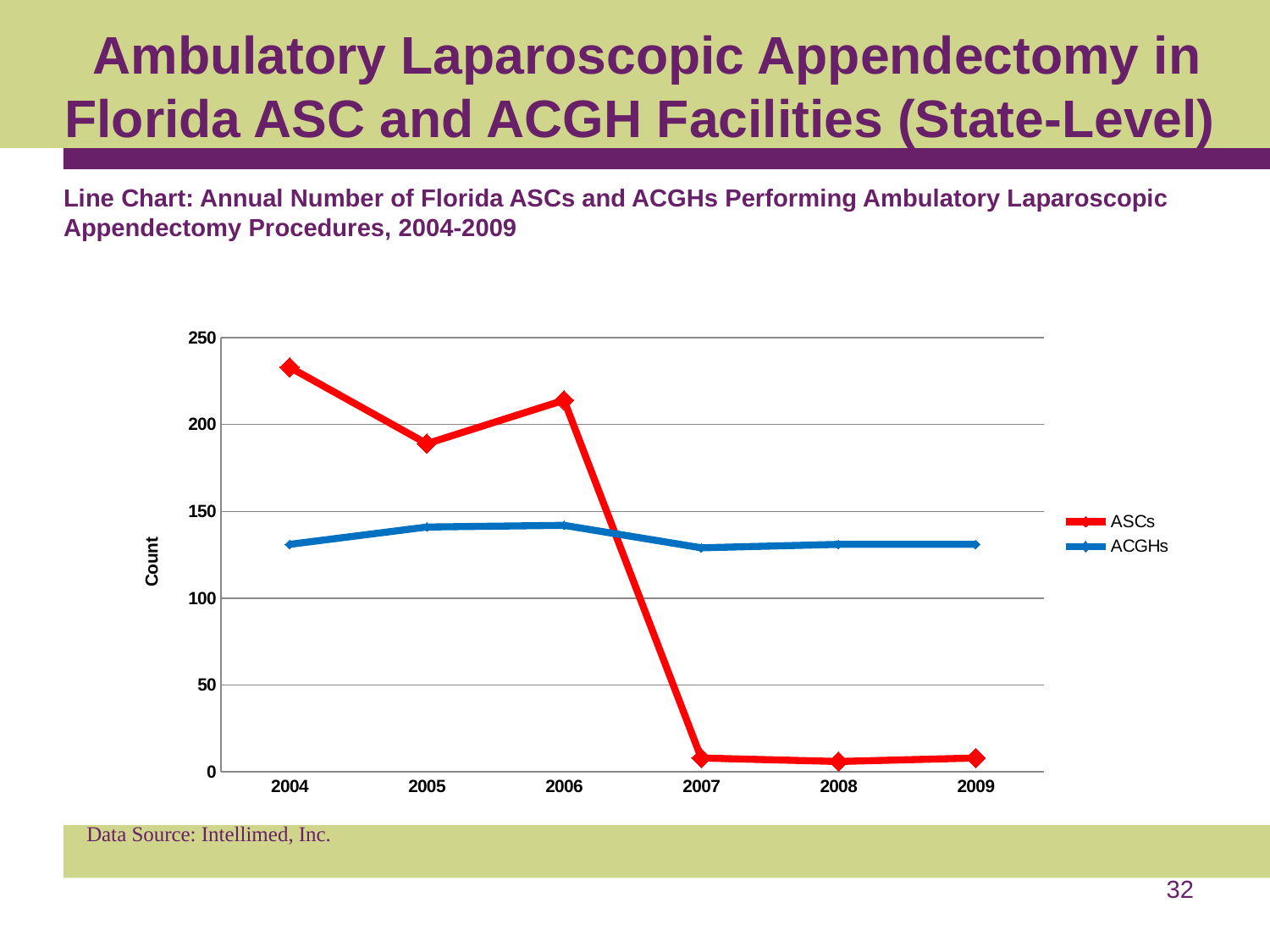
Is the ASCs value for 2005 greater or less than 200? less In which year is the ASCs value highest? 2004 Is the ACGHs value for 2005 greater or less than 150? less What is the label on the y axis? Count Which series has the larger value in 2008, ASCs or ACGHs? ACGHs What kind of chart is shown on the slide? line chart Is the ASCs value for 2007 greater or less than 50? less Which series has the larger value in 2004, ASCs or ACGHs? ASCs How many years are plotted along the x axis? 6 How many series does the legend list? 2 Do the ASCs values rise or fall overall from 2004 to 2009? fall